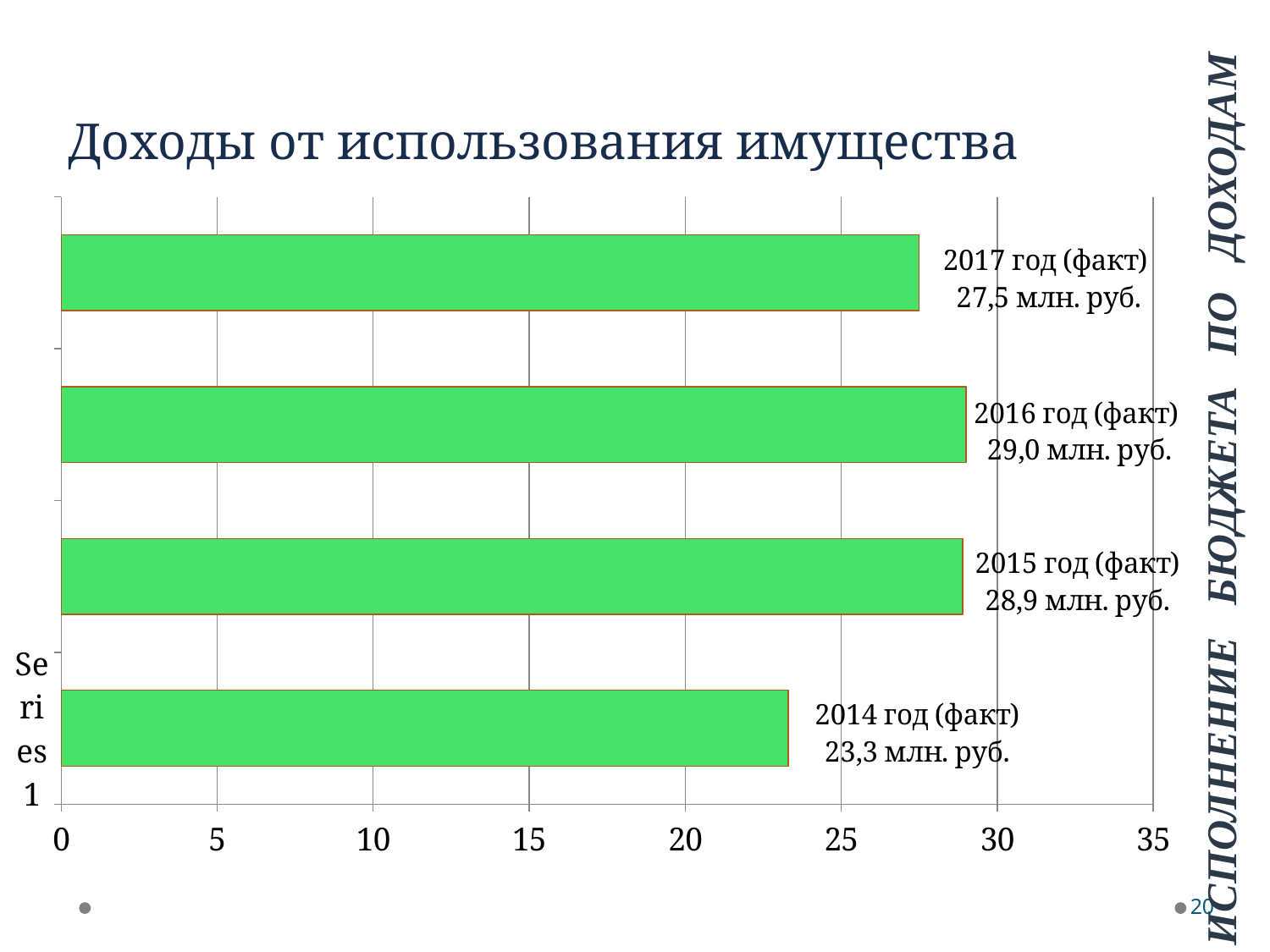
What is the value for 2015 год (факт)? 28,9 млн. руб. How many bars are shown in the chart? 4 What is the value for 2014 год (факт)? 23,3 млн. руб. Which year has the lowest value? 2014 год (факт) Which is larger, the value for 2017 год (факт) or for 2014 год (факт)? 2017 год (факт) What is the value for 2016 год (факт)? 29,0 млн. руб. What kind of chart is shown on the slide? bar chart What is the title of the chart? Доходы от использования имущества What is the value for 2017 год (факт)? 27,5 млн. руб. What is the difference between the values for 2017 год (факт) and 2014 год (факт)? 4,2 млн. руб. Is the value for 2014 год (факт) greater or less than 25? less Is the value for 2016 год (факт) greater or less than 25? greater